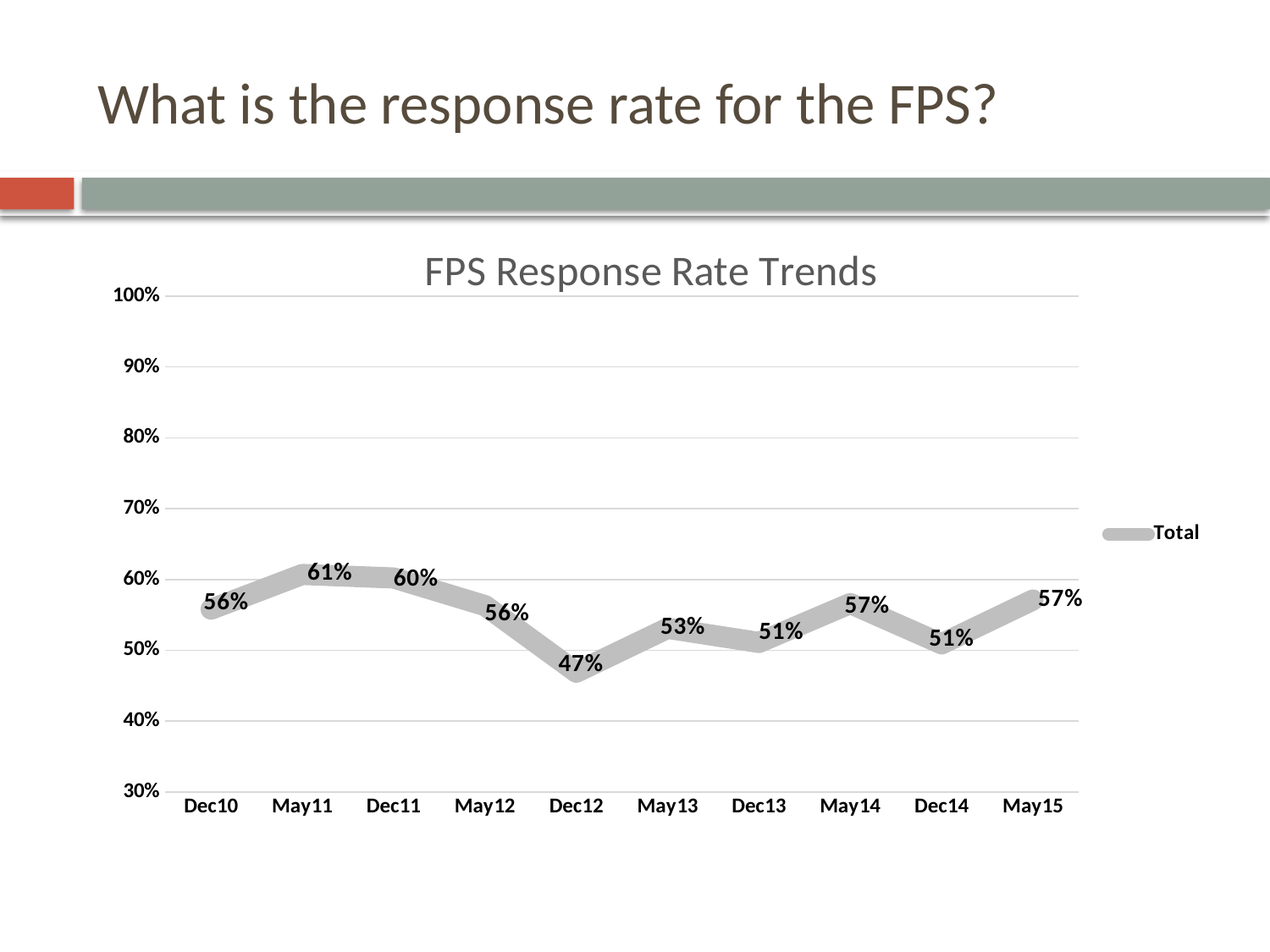
How many time periods are plotted on the x axis? 10 Which period has the highest response rate? May11 Which is larger, the response rate for Dec11 or for May13? Dec11 What is the title of the chart? FPS Response Rate Trends How many series does the legend list? 1 What is the response rate for Dec12? 47% Is the response rate for Dec12 greater or less than 50%? less Which period has the lowest response rate? Dec12 What kind of chart is shown? line chart What is the difference between the response rates for May11 and Dec12? 14% What is the response rate for May15? 57% What is the response rate for May11? 61%